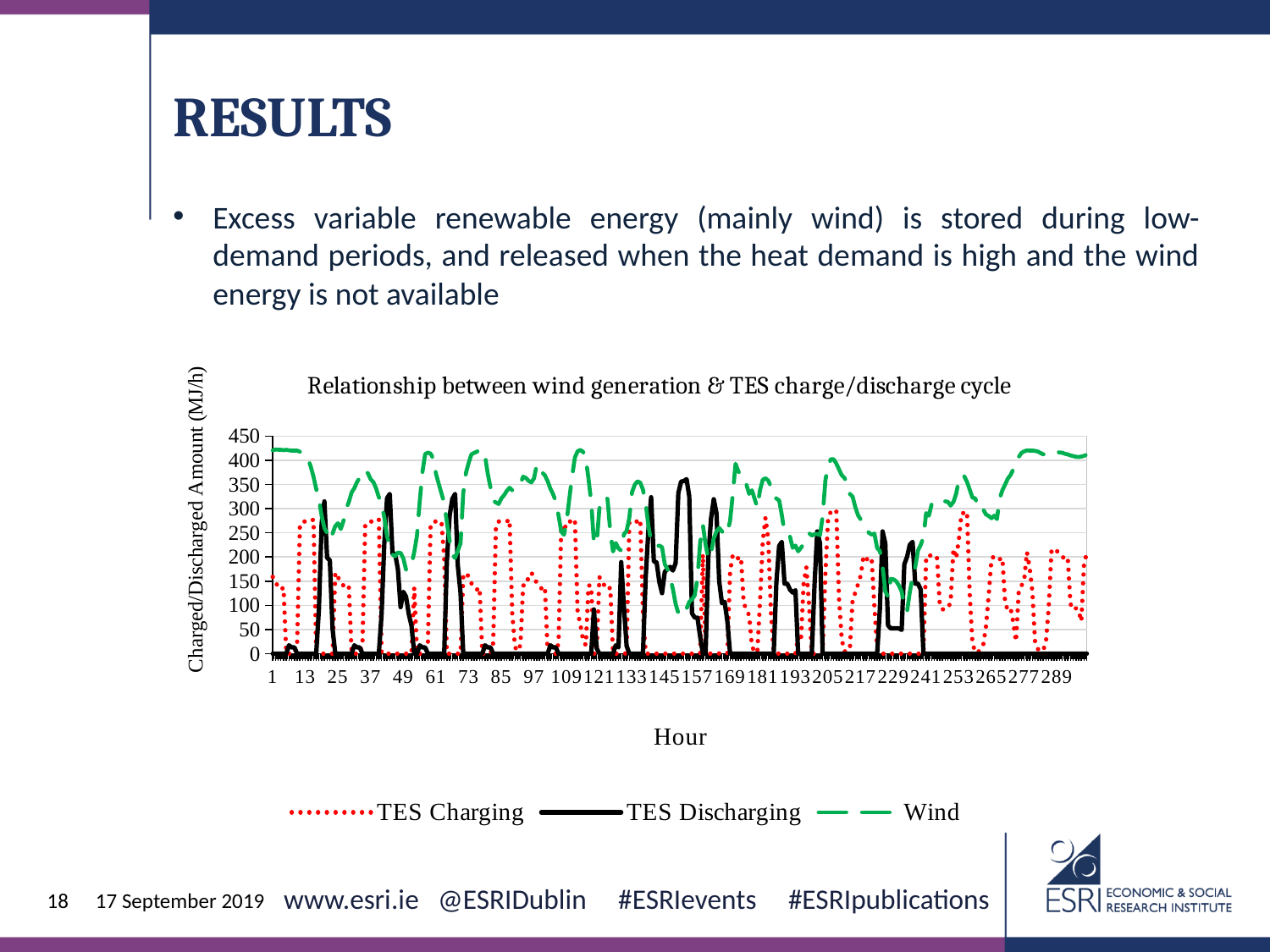
Does the TES Discharging line ever rise above 400 MJ/h? no How many series does the legend list? 3 What kind of chart is shown on the slide? line chart Is the TES Charging value at hour 1 greater or less than 100? greater What is the title of the chart? Relationship between wind generation & TES charge/discharge cycle Is the TES Discharging value at hour 1 greater or less than 100? less Which series is drawn with the solid black line? TES Discharging